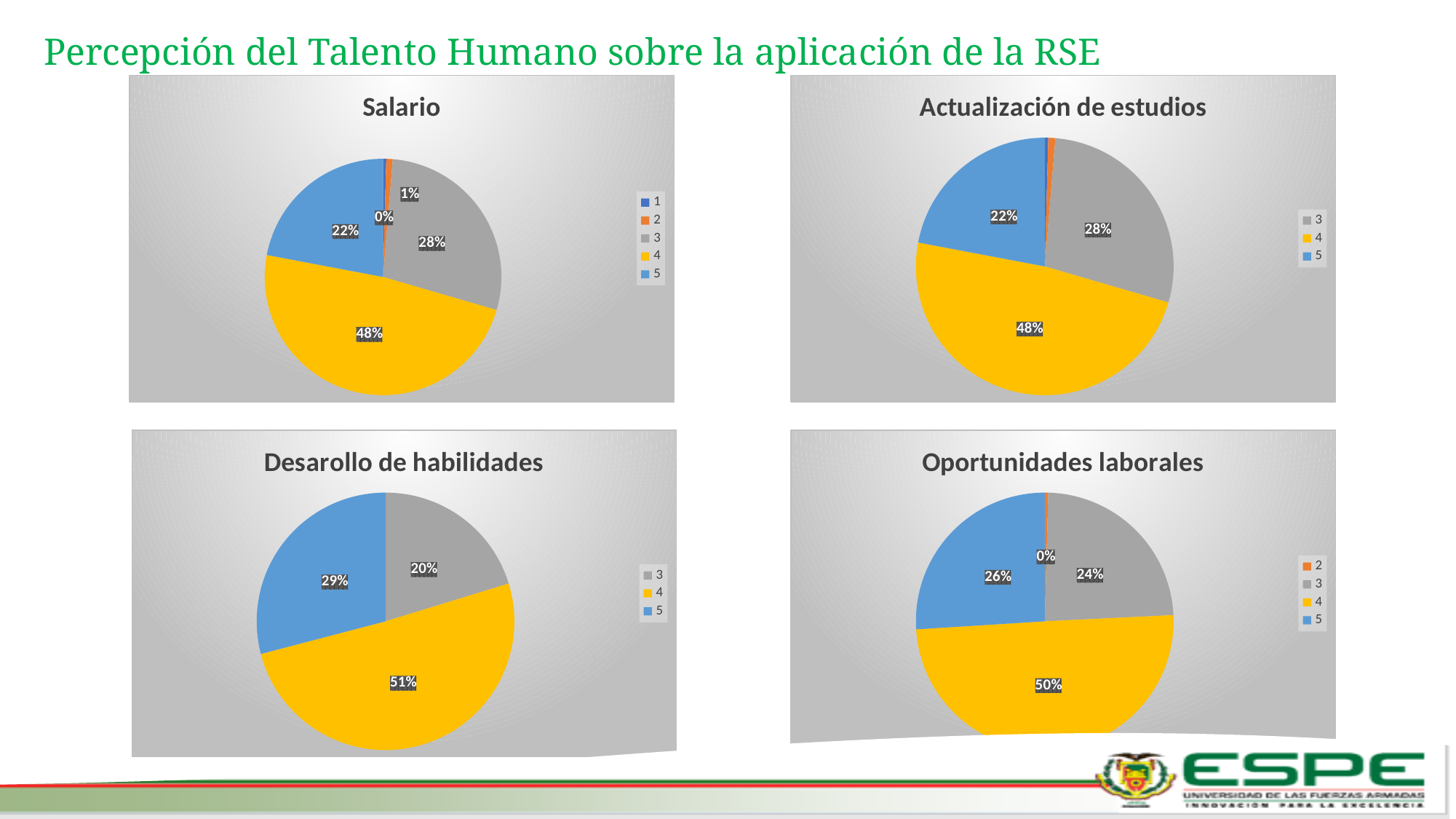
In the 'Salario' pie chart, what is the difference between the shares of category 3 and category 5? 6% In the 'Oportunidades laborales' pie chart, what percentage is shown for category 4? 50% In the 'Actualización de estudios' pie chart, what percentage is shown for category 5? 22% What type of chart is 'Actualización de estudios'? Pie chart In the 'Desarollo de habilidades' pie chart, what percentage is shown for category 3? 20% In the 'Salario' pie chart, what percentage is shown for category 4? 48% In the 'Oportunidades laborales' pie chart, which category has the smallest share? 2 How many entries does the legend of the 'Salario' chart list? 5 In the 'Desarollo de habilidades' pie chart, which category has the largest share? 4 In the 'Salario' pie chart, what percentage is shown for category 2? 1% How many entries does the legend of the 'Oportunidades laborales' chart list? 4 In the 'Desarollo de habilidades' pie chart, which is larger: the share of category 5 or category 3? 5